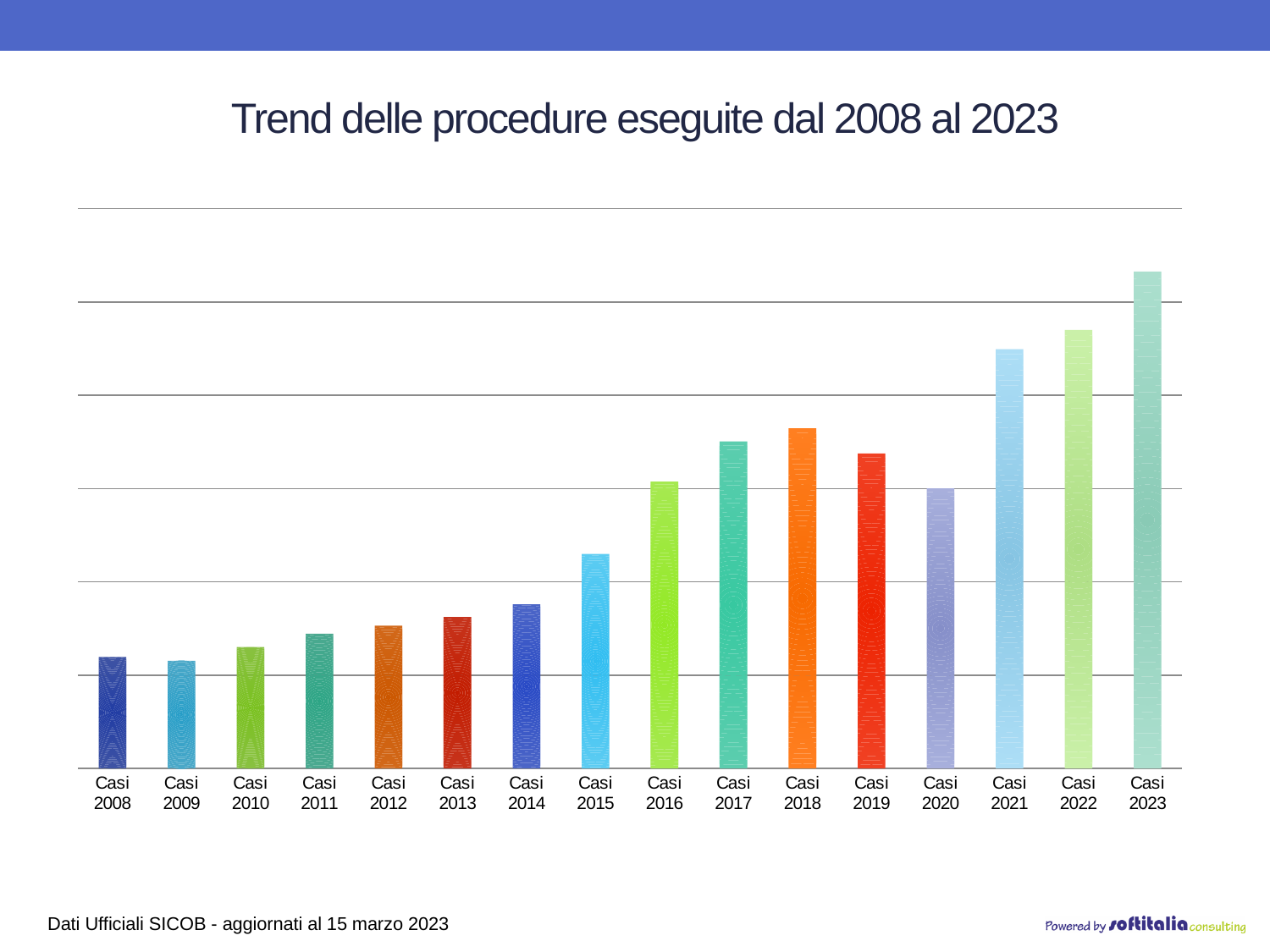
Between Casi 2019 and Casi 2020, does the value rise or fall? Fall What is the data source noted at the bottom of the slide? Dati Ufficiali SICOB - aggiornati al 15 marzo 2023 What is the title of the chart? Trend delle procedure eseguite dal 2008 al 2023 How many categories (years) are shown on the x axis of the chart? 16 Which is larger, the value for Casi 2018 or the value for Casi 2019? Casi 2018 Which is larger, the value for Casi 2021 or the value for Casi 2022? Casi 2022 Which is larger, the value for Casi 2015 or the value for Casi 2016? Casi 2016 What kind of chart is shown on the slide? Bar chart Which category has the highest value in the chart? Casi 2023 Do the values generally rise or fall from Casi 2008 to Casi 2023? Rise